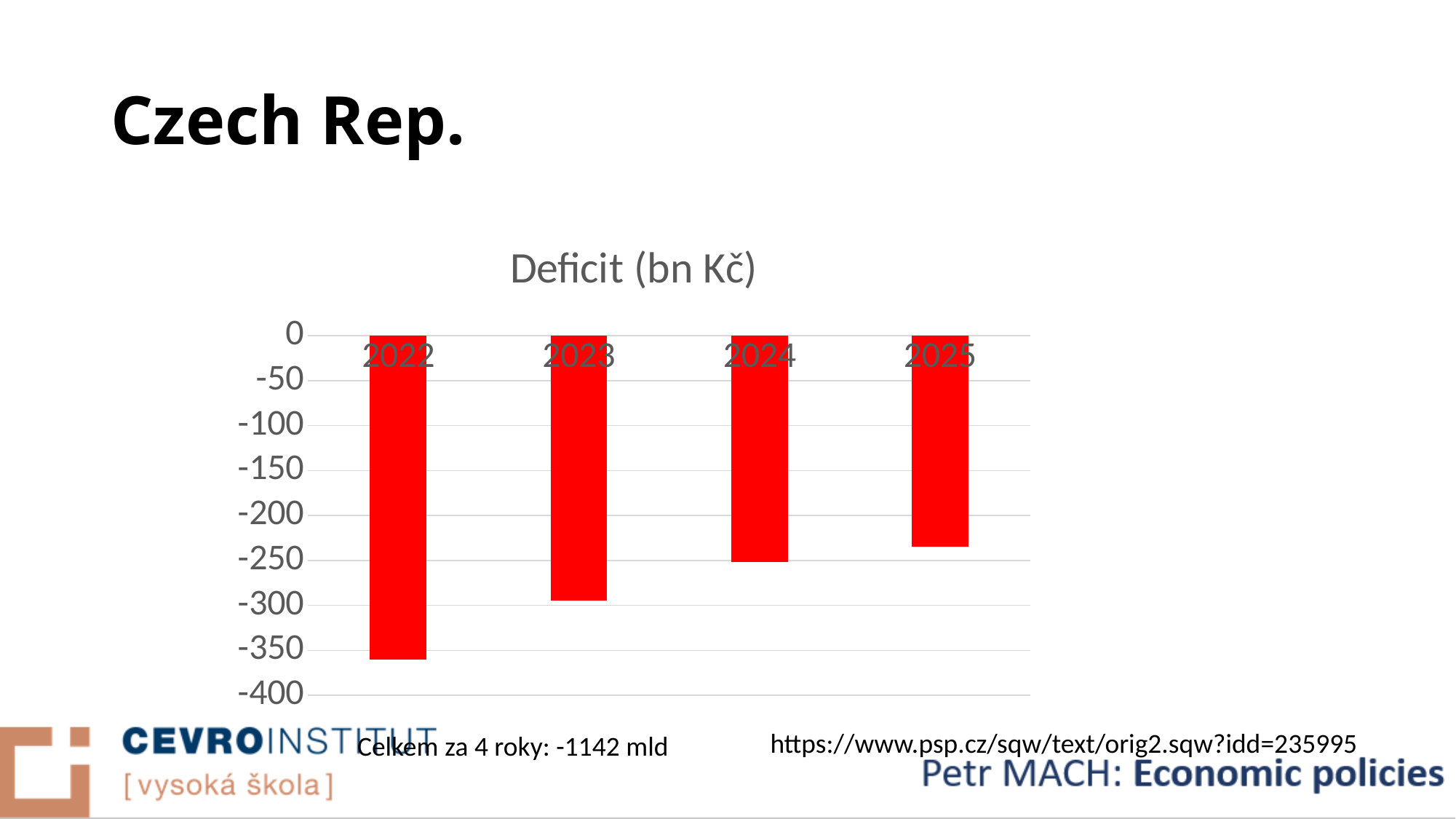
Do the deficit values rise or fall (move toward zero or away from it) from 2022 to 2025? rise toward zero (deficits shrink) Is the value for 2025 greater or less than -250? greater Is the value for 2022 greater or less than -300? less What colour are the bars in the chart? red What is the title of the chart? Deficit (bn Kč) Is the value for 2024 greater or less than -200? less Which year has a larger deficit, 2022 or 2023? 2022 What kind of chart is shown on the slide? bar chart Which year has the largest deficit (the longest bar)? 2022 How many years are plotted in the chart? 4 Which year has the smallest deficit (the shortest bar)? 2025